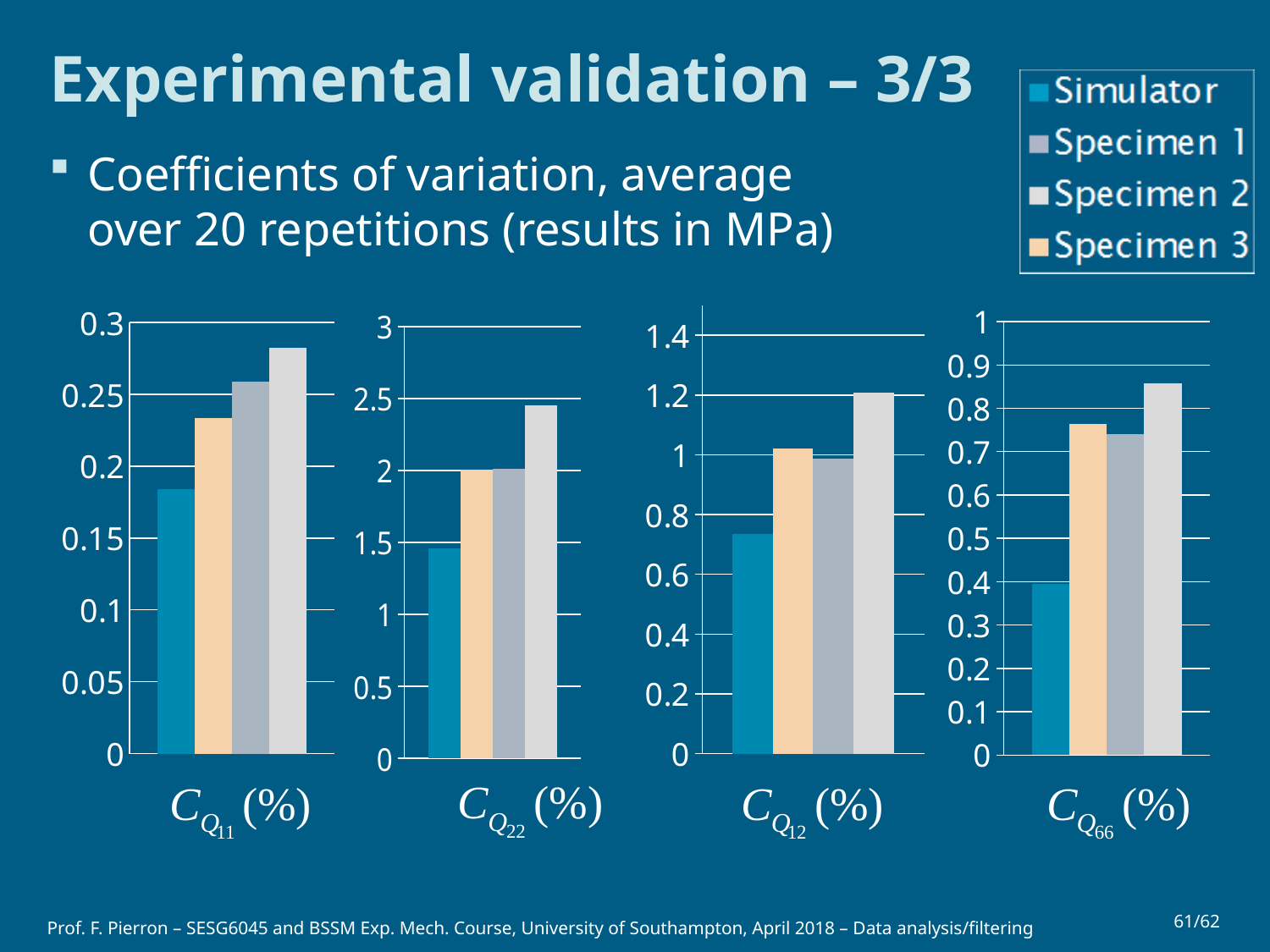
How many series does the legend list? 4 In the C_Q66 (%) chart, which is larger, the value for Specimen 3 or the value for Simulator? Specimen 3 In the C_Q12 (%) chart, is the value for Simulator greater or less than 0.8? less In the C_Q12 (%) chart, which series has the highest value? Specimen 2 How many bar charts are shown on the slide? 4 In the C_Q11 (%) chart, which series has the lowest value? Simulator In the C_Q11 (%) chart, which series has the highest value? Specimen 2 In the C_Q22 (%) chart, is the value for Specimen 2 greater or less than 2? greater In the C_Q11 (%) chart, is the value for Simulator greater or less than 0.2? less In the C_Q22 (%) chart, which series has the lowest value? Simulator What kind of chart is used for C_Q11 (%)? bar chart